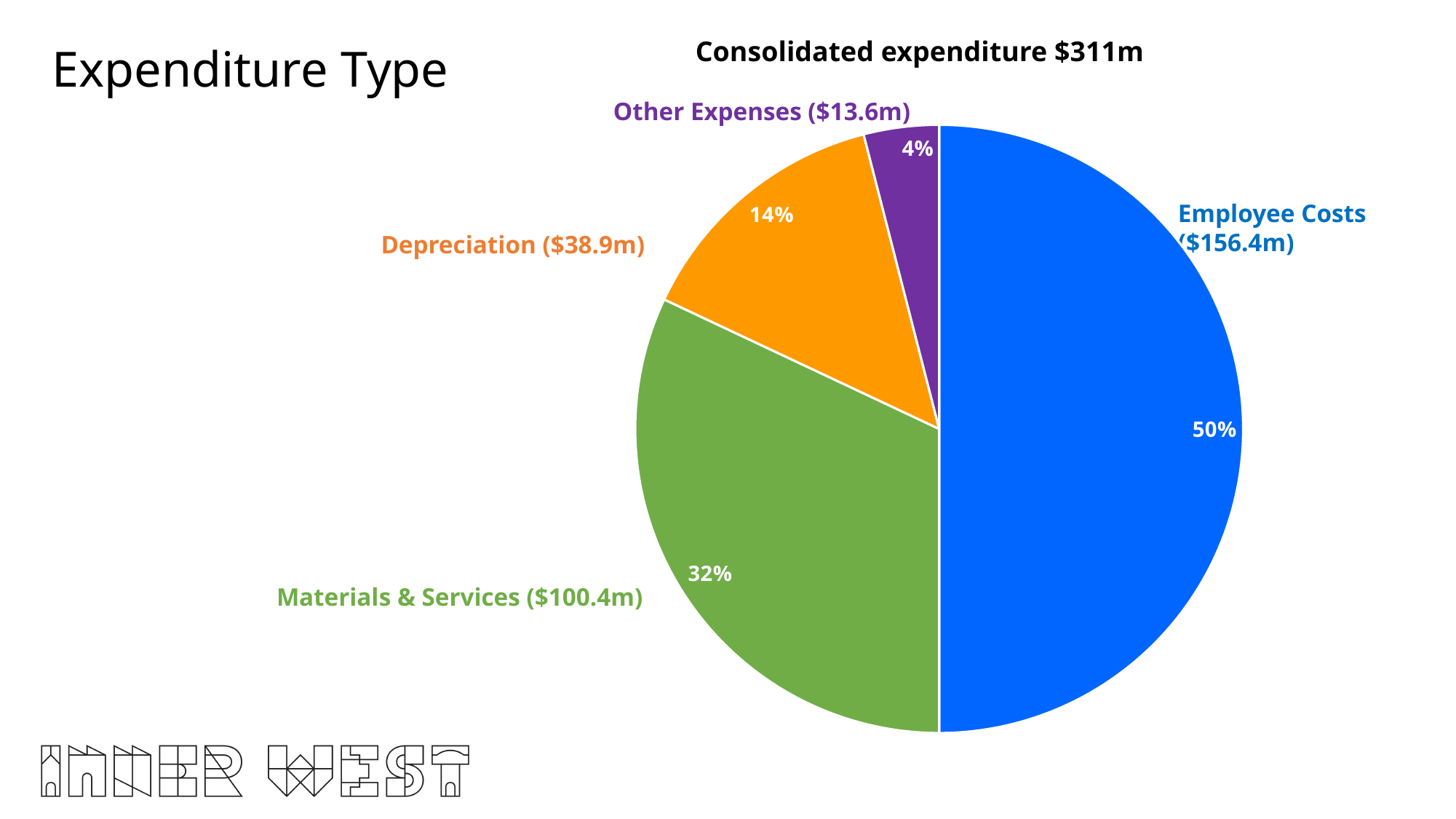
What share of the pie is Depreciation? 14% What is the value shown for Depreciation? $38.9m What share of the pie is Materials & Services? 32% How many slices does the pie chart have? 4 Which expenditure type is the smallest? Other Expenses What is the title of the chart? Consolidated expenditure $311m Which expenditure type is the largest? Employee Costs What share of the pie is Employee Costs? 50% What kind of chart is shown on the slide? Pie chart Which is larger, Materials & Services or Depreciation? Materials & Services What is the value shown for Employee Costs? $156.4m